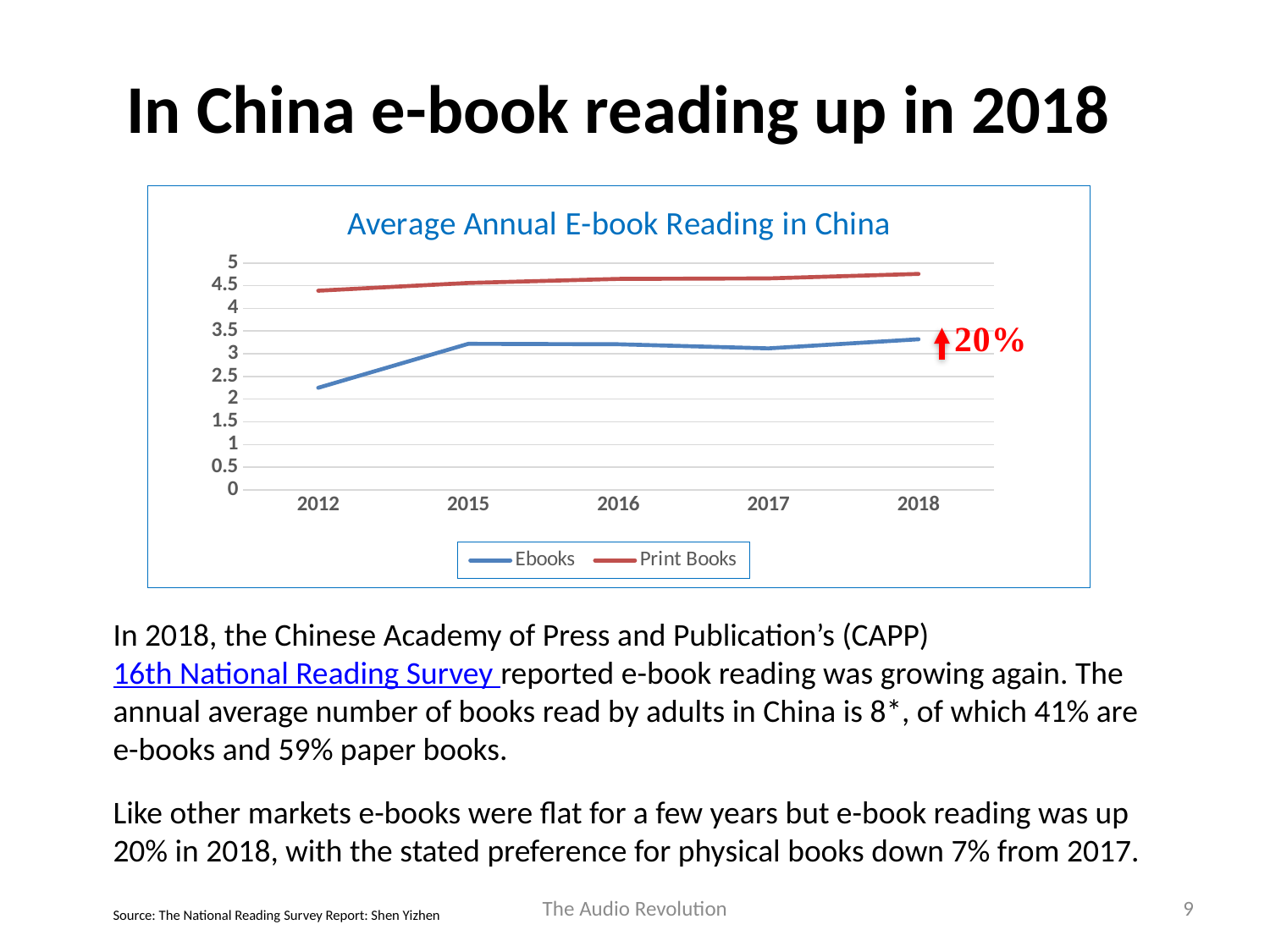
How many series does the legend list? 2 Is the Print Books value for 2018 greater or less than 4.5? greater What kind of chart is shown on the slide? line chart In which year is the Ebooks value lowest? 2012 How many years are plotted along the x axis? 5 Does the Print Books line rise or fall from 2012 to 2018? rise In which year is the Print Books value lowest? 2012 What is the title of the chart? Average Annual E-book Reading in China Is the Ebooks value for 2012 greater or less than 2.5? less What percentage annotation is shown next to the end of the Ebooks line? 20% Which series has the larger value in 2018, Ebooks or Print Books? Print Books Is the Ebooks value for 2015 greater or less than 3.5? less